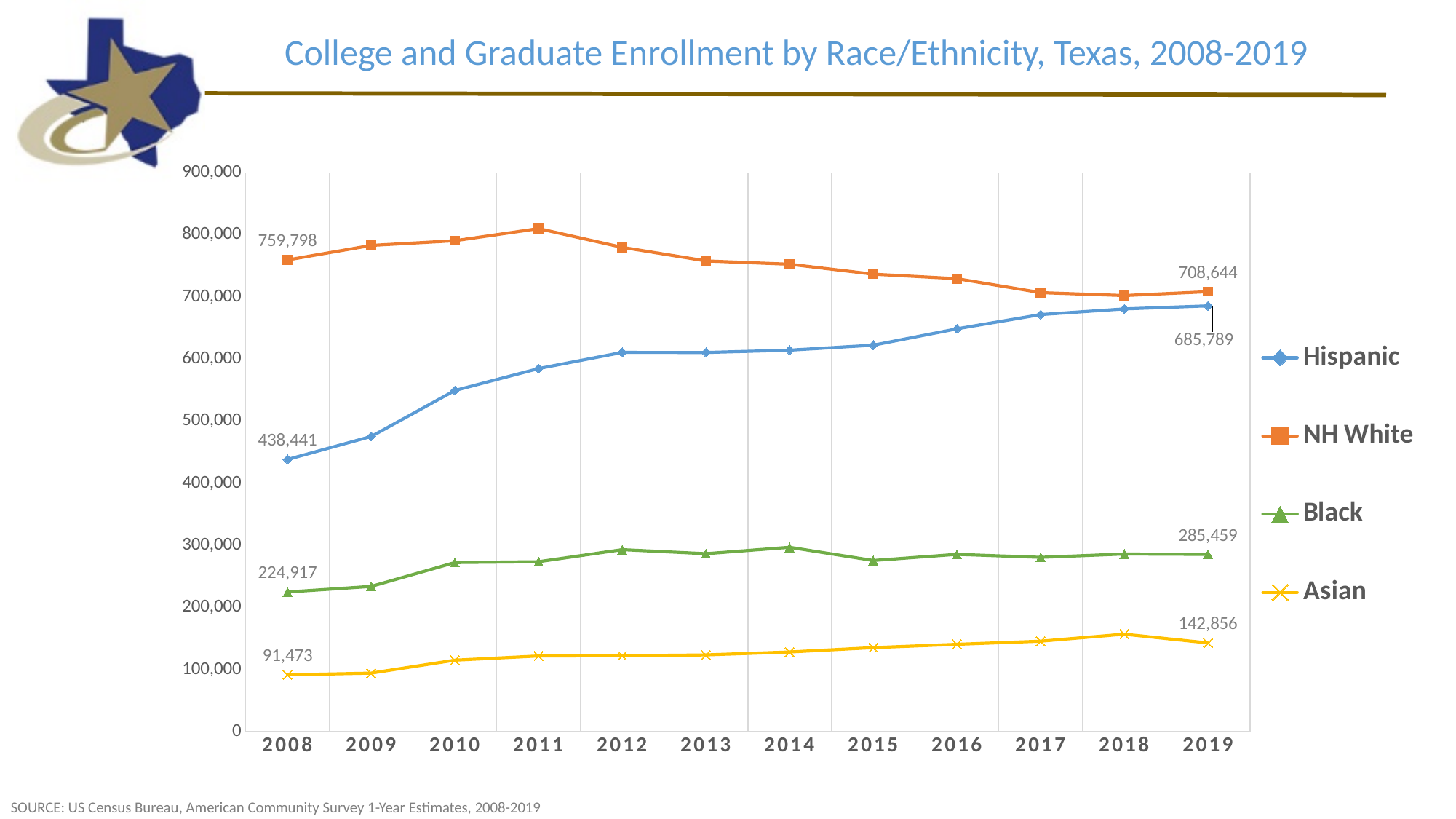
What was the Black enrollment in 2019? 285,459 What was the Asian enrollment in 2008? 91,473 What kind of chart is shown on the slide? Line chart Is the Hispanic enrollment in 2012 greater or less than 500,000? greater Which series had the lowest enrollment in 2008? Asian What was the NH White enrollment in 2008? 759,798 What was the Hispanic enrollment in 2019? 685,789 Which was larger in 2019, Black enrollment or Asian enrollment? Black By how much did Hispanic enrollment increase from 2008 to 2019? 247,348 Which series had the highest enrollment in 2019? NH White How many series does the legend list? 4 By how much did NH White enrollment decrease from 2008 to 2019? 51,154